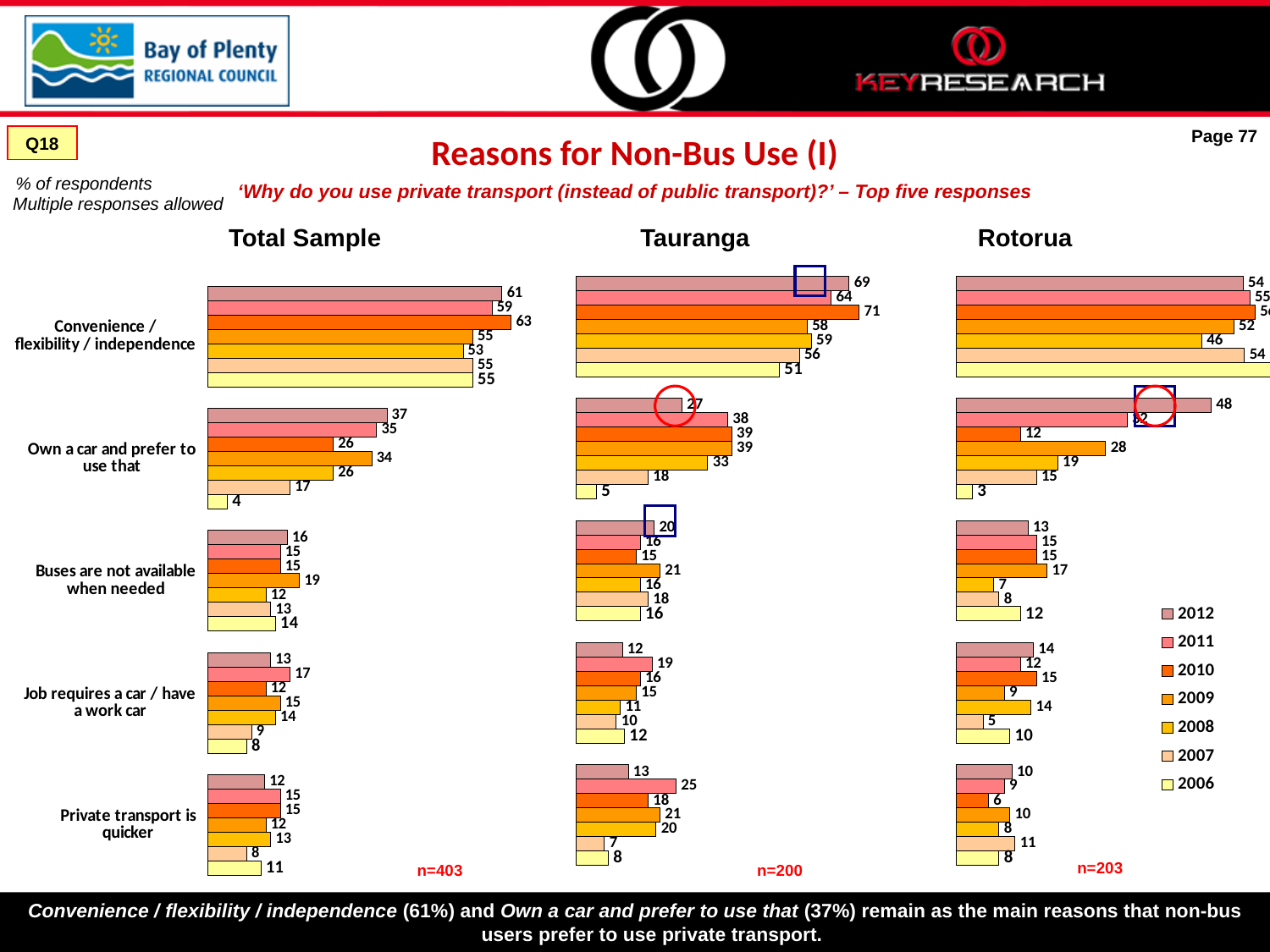
In the Rotorua chart, which reason has the lowest 2012 value? Private transport is quicker In the Tauranga chart, what is the 2010 value for 'Convenience / flexibility / independence'? 71 In the Total Sample chart, what is the 2012 value for 'Convenience / flexibility / independence'? 61 How many series does the legend list? 7 How many reason categories are shown in the Tauranga chart? 5 In the Tauranga chart, which is larger for 'Own a car and prefer to use that': the 2012 value or the 2011 value? 2011 In the Total Sample chart, what is the difference between the 2012 values for 'Convenience / flexibility / independence' and 'Own a car and prefer to use that'? 24 What kind of chart is used for the Total Sample data? Bar chart In the Total Sample chart, what is the 2006 value for 'Own a car and prefer to use that'? 4 In the Total Sample chart, which reason has the highest 2012 value? Convenience / flexibility / independence In the Rotorua chart, what is the 2012 value for 'Own a car and prefer to use that'? 48 In the Tauranga chart, what is the 2011 value for 'Private transport is quicker'? 25